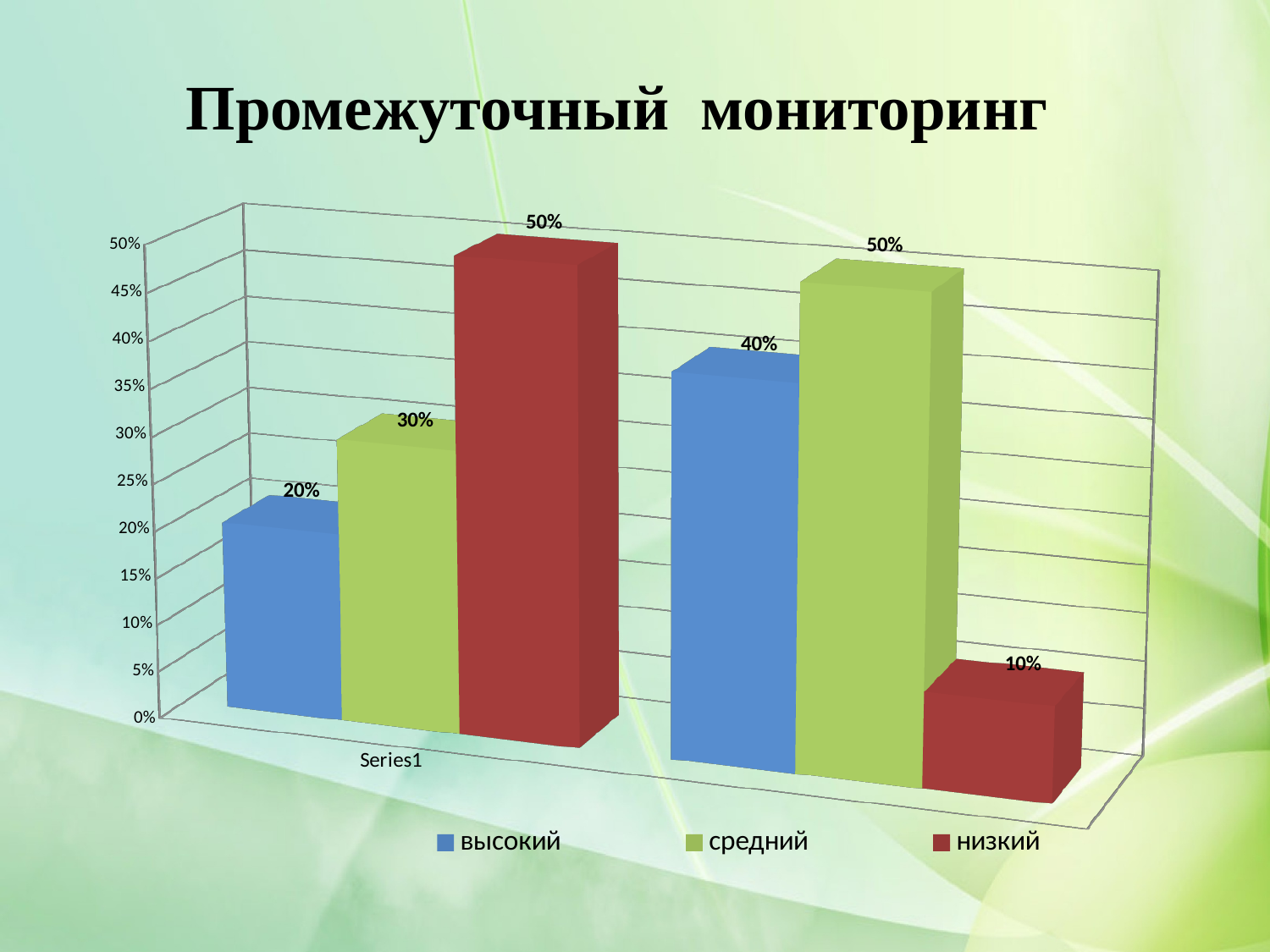
Which colour represents the средний series in the legend? green What kind of chart is shown on the slide? bar chart What is the value of the высокий bar in the Series1 group? 20% Which series has the lowest value in the Series1 group? высокий How many series does the legend list? 3 What is the difference between the низкий and высокий values in the Series1 group? 30% What is the title of the slide? Промежуточный мониторинг In the right-hand group of bars, which is larger: высокий or средний? средний What is the value of the средний bar in the Series1 group? 30% In the right-hand group of bars, what is the value of the низкий bar? 10% What is the value of the низкий bar in the Series1 group? 50% Which series has the highest value in the Series1 group? низкий